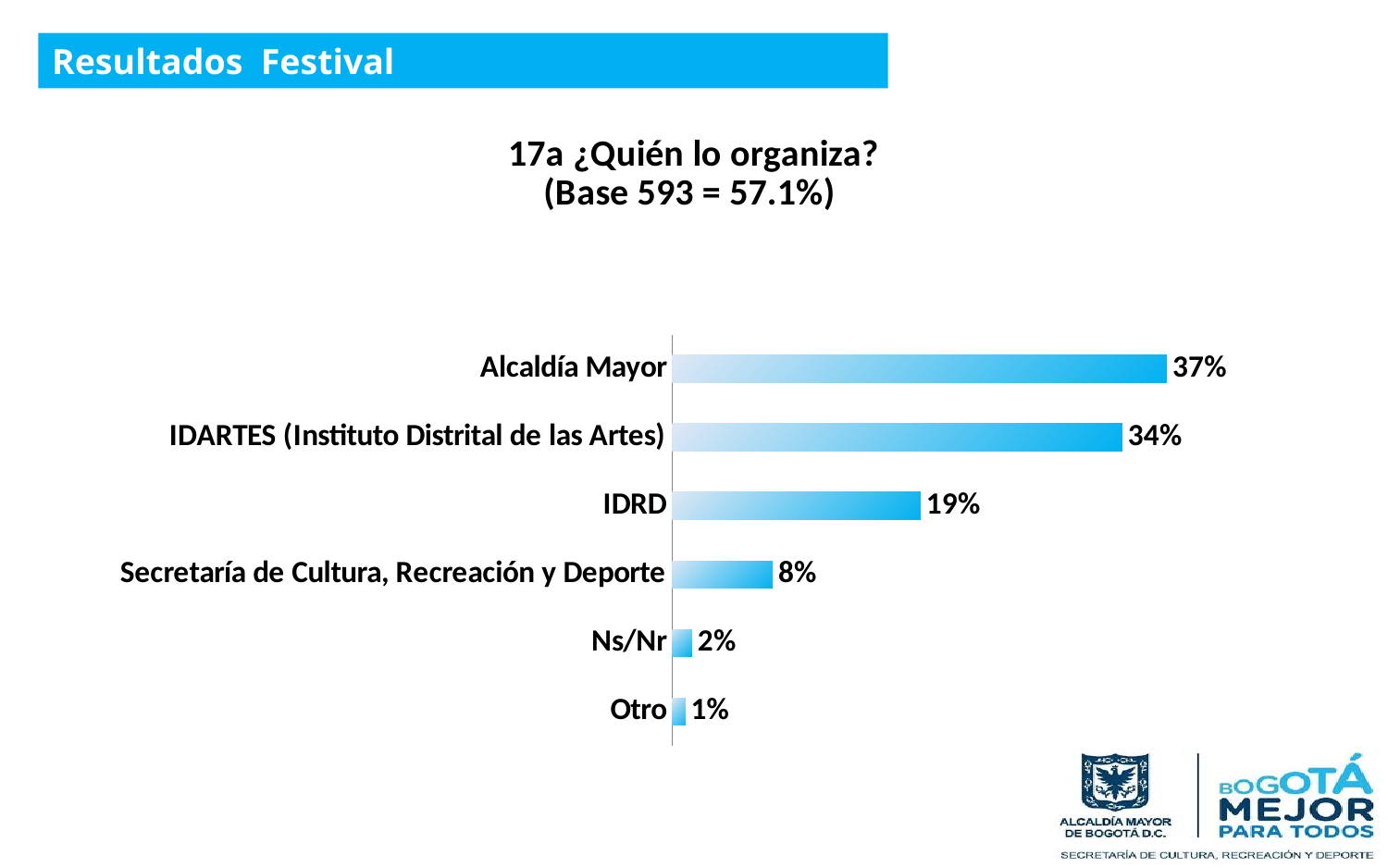
Which is larger, the value for IDRD or the value for Secretaría de Cultura, Recreación y Deporte? IDRD Which category has the highest value? Alcaldía Mayor What percentage is shown for Alcaldía Mayor? 37% What kind of chart is shown on the slide? Bar chart How many categories are shown in the chart? 6 Which category has the lowest value? Otro What is the title of the chart? 17a ¿Quién lo organiza? (Base 593 = 57.1%) What is the difference between the values for Alcaldía Mayor and IDRD? 18% What percentage is shown for Secretaría de Cultura, Recreación y Deporte? 8% What percentage is shown for IDRD? 19% What percentage is shown for IDARTES (Instituto Distrital de las Artes)? 34% What percentage is shown for Ns/Nr? 2%